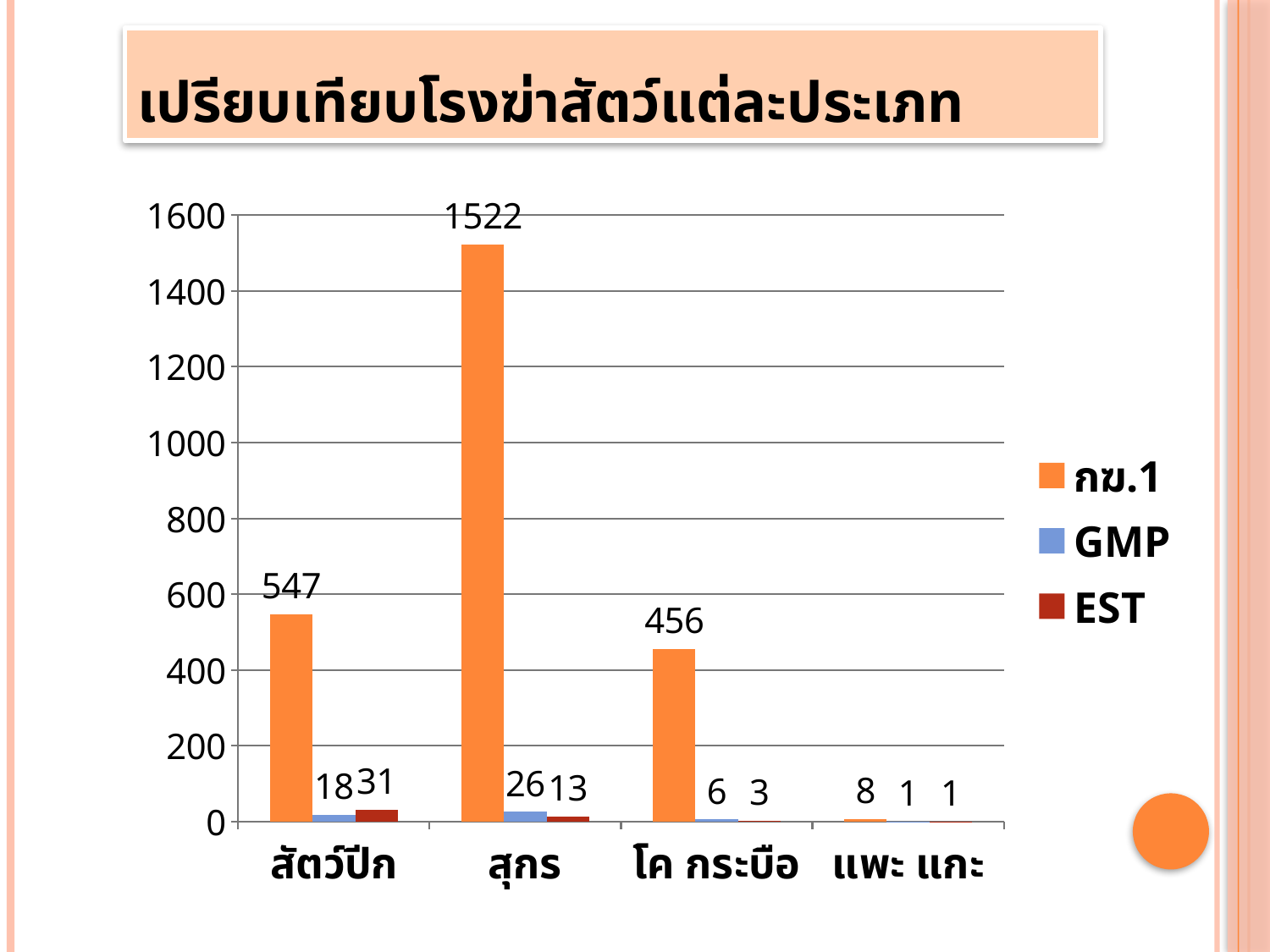
Which category has the lowest กฆ.1 value? แพะ แกะ What is the GMP value for สัตว์ปีก? 18 Is the กฆ.1 value for โค กระบือ greater or less than 600? less What is the difference between the กฆ.1 values for สุกร and สัตว์ปีก? 975 What kind of chart is shown on the slide? bar chart What is the EST value for โค กระบือ? 3 How many series does the legend list? 3 How many categories are shown on the x axis? 4 Which category has the highest กฆ.1 value? สุกร What is the value of กฆ.1 for สุกร? 1522 Which is larger for สัตว์ปีก: the GMP value or the EST value? EST What is the title of the chart on the slide? เปรียบเทียบโรงฆ่าสัตว์แต่ละประเภท